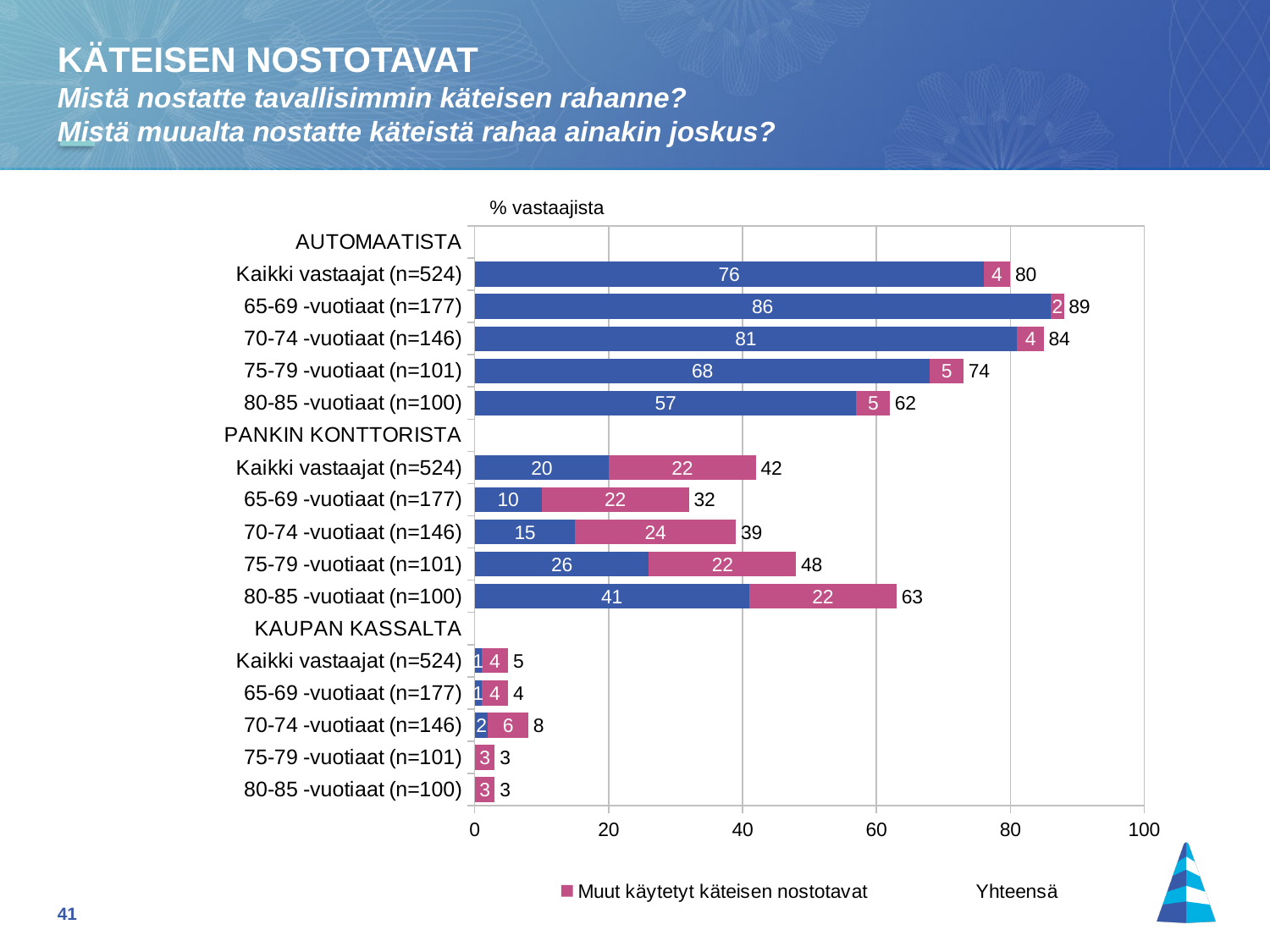
What is the total for 70-74 -vuotiaat (n=146) under KAUPAN KASSALTA? 8 What is the difference between the totals for 65-69 -vuotiaat (n=177) and 80-85 -vuotiaat (n=100) under AUTOMAATISTA? 27 Is the total for 80-85 -vuotiaat (n=100) under PANKIN KONTTORISTA greater or less than 60? greater What is the label shown above the chart describing the unit of the values? % vastaajista What is the total (Yhteensä) value for Kaikki vastaajat (n=524) under AUTOMAATISTA? 80 What is the value of the pink 'Muut käytetyt käteisen nostotavat' segment for 75-79 -vuotiaat (n=101) under AUTOMAATISTA? 5 How many bars are plotted under the KAUPAN KASSALTA section? 5 What kind of chart is shown on the slide? bar chart Which age group has the lowest total under PANKIN KONTTORISTA? 65-69 -vuotiaat (n=177) Which age group has the highest total under AUTOMAATISTA? 65-69 -vuotiaat (n=177) Under PANKIN KONTTORISTA, which is larger: the total for 75-79 -vuotiaat (n=101) or the total for 70-74 -vuotiaat (n=146)? 75-79 -vuotiaat (n=101) What is the value of the blue segment for 80-85 -vuotiaat (n=100) under PANKIN KONTTORISTA? 41